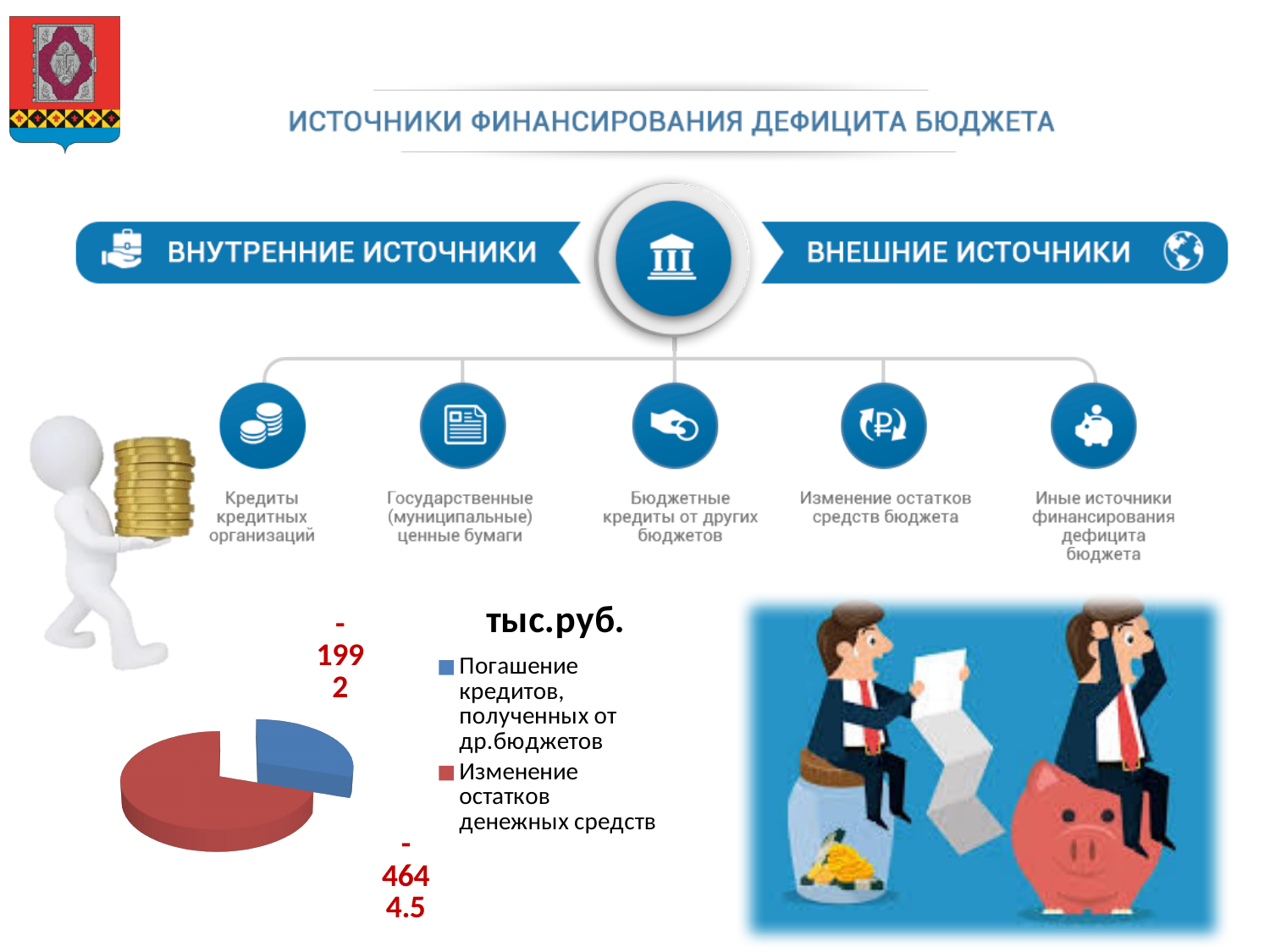
Which slice is larger in the pie chart: "Погашение кредитов, полученных от др.бюджетов" or "Изменение остатков денежных средств"? Изменение остатков денежных средств What value is shown for "Погашение кредитов, полученных от др.бюджетов" in the pie chart? -1992 What is the title of the pie chart? тыс.руб. What value is shown for "Изменение остатков денежных средств" in the pie chart? -4644.5 What kind of chart is shown at the bottom left of the slide? pie chart How many entries does the legend of the pie chart list? 2 What colour is the slice for "Изменение остатков денежных средств" in the pie chart? red How many slices does the pie chart have? 2 By how much do the absolute values of "Изменение остатков денежных средств" and "Погашение кредитов, полученных от др.бюджетов" differ in the pie chart? 2652.5 Which category takes up the largest slice of the pie chart? Изменение остатков денежных средств Which category takes up the smallest slice of the pie chart? Погашение кредитов, полученных от др.бюджетов